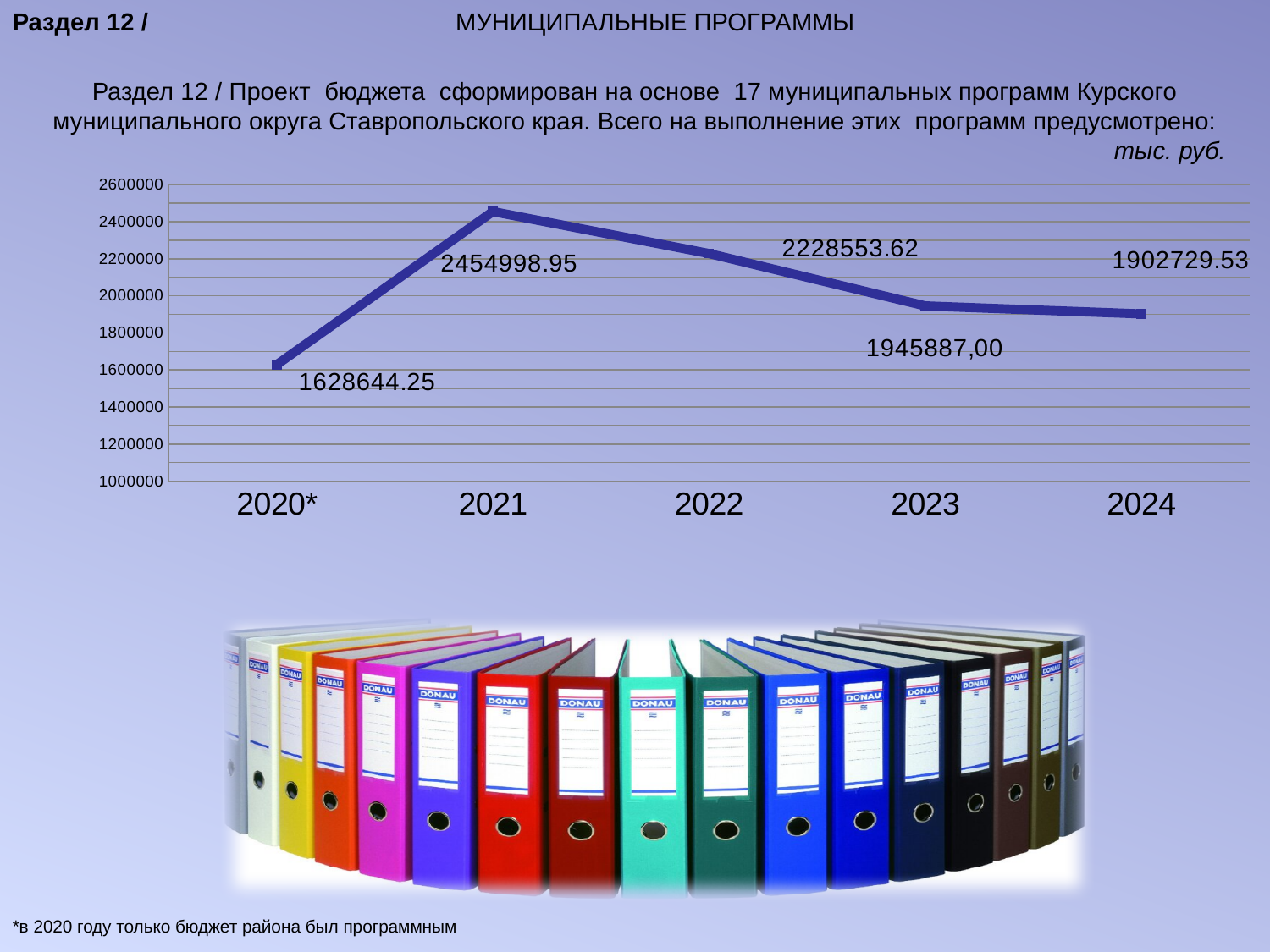
Which year has the highest value on the line chart? 2021 What is the difference between the values for 2021 and 2020*? 826354.70 What is the value for 2020* on the line chart? 1628644.25 What is the difference between the values for 2021 and 2022? 226445.33 Which year has the lowest value on the line chart? 2020* How many years are plotted on the line chart? 5 Which is larger, the value for 2022 or the value for 2023? 2022 What is the value for 2024 on the line chart? 1902729.53 What is the value for 2021 on the line chart? 2454998.95 What is the value for 2023 on the line chart? 1945887,00 Is the value for 2023 greater or less than 2000000? less What kind of chart is shown on the slide? line chart